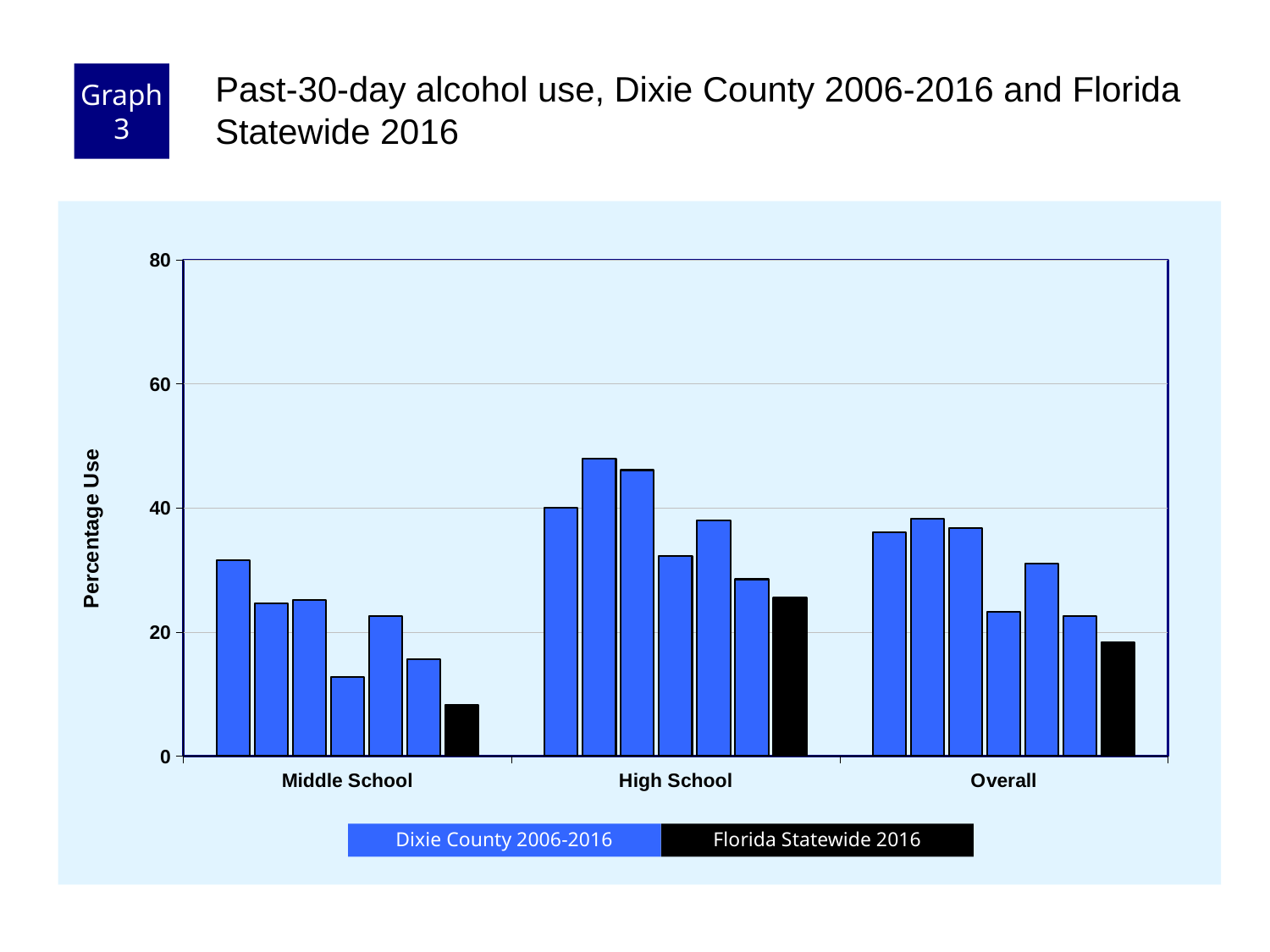
What kind of chart is shown on the slide? bar chart Is the Florida Statewide 2016 value for High School larger than the Florida Statewide 2016 value for Middle School? yes What is the label of the y axis? Percentage Use Which category has the lowest Florida Statewide 2016 value? Middle School Is the tallest Dixie County 2006-2016 bar for Middle School greater or less than 40? less Which category contains the tallest bar on the chart? High School How many categories are shown on the x axis? 3 Which colour represents Florida Statewide 2016 in the legend? black Is the Florida Statewide 2016 value for Middle School greater or less than 20? less How many series does the legend list? 2 Is the tallest Dixie County 2006-2016 bar for High School greater or less than 40? greater